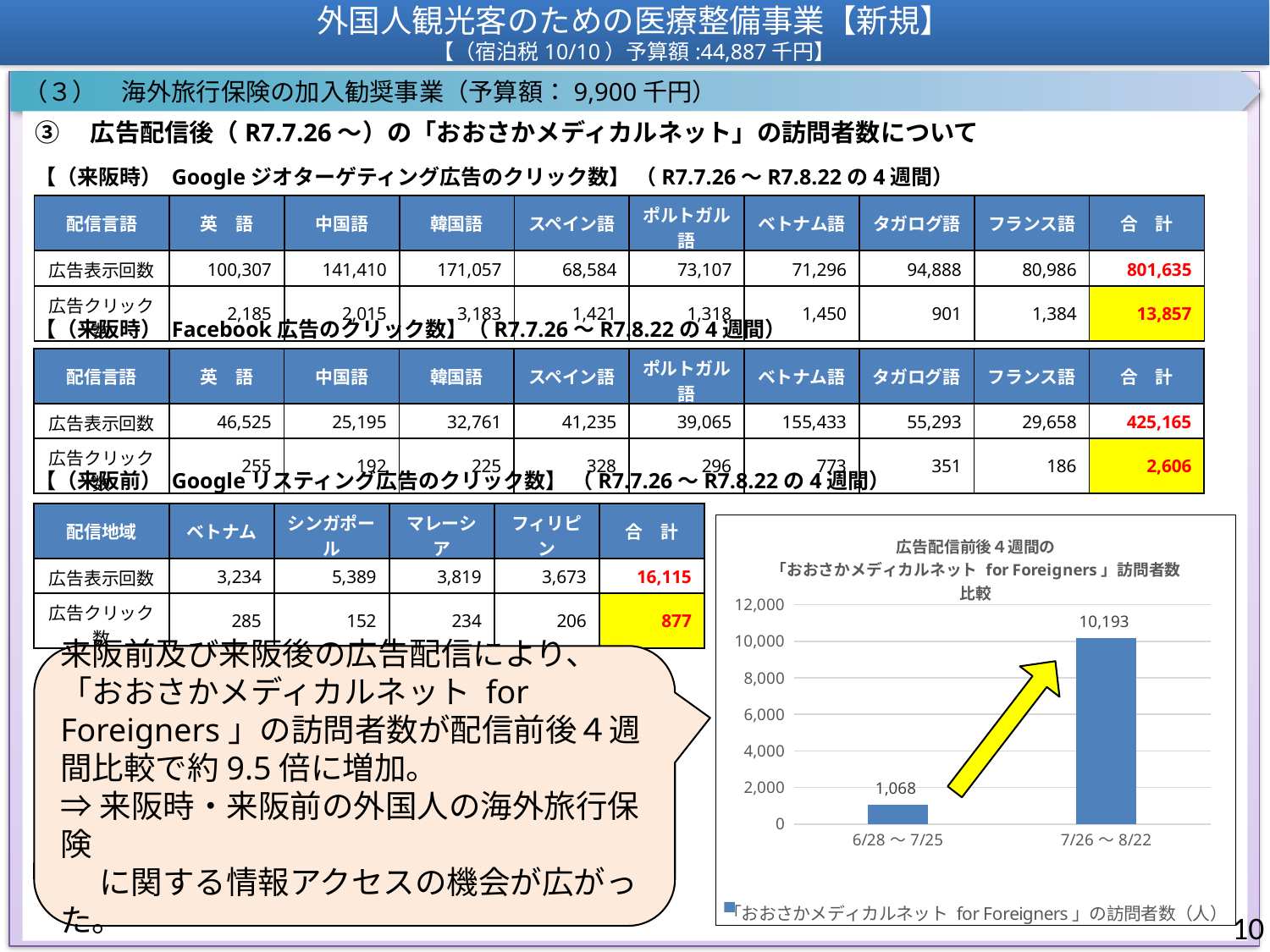
Which period has the lowest value in the chart? 6/28 〜 7/25 How many series does the chart legend list? 1 Is the value for 7/26 〜 8/22 greater or less than 8,000? greater Do the values rise or fall from 6/28 〜 7/25 to 7/26 〜 8/22? Rise What is the value for 7/26 〜 8/22 in the chart? 10,193 What is the difference between the values for 7/26 〜 8/22 and 6/28 〜 7/25? 9,125 Is the value for 6/28 〜 7/25 greater or less than 2,000? less What is the value for 6/28 〜 7/25 in the chart? 1,068 Which is larger, the value for 6/28 〜 7/25 or the value for 7/26 〜 8/22? 7/26 〜 8/22 How many periods (bars) are shown in the chart? 2 Which period has the highest value in the chart? 7/26 〜 8/22 What kind of chart is shown on the slide? Bar chart